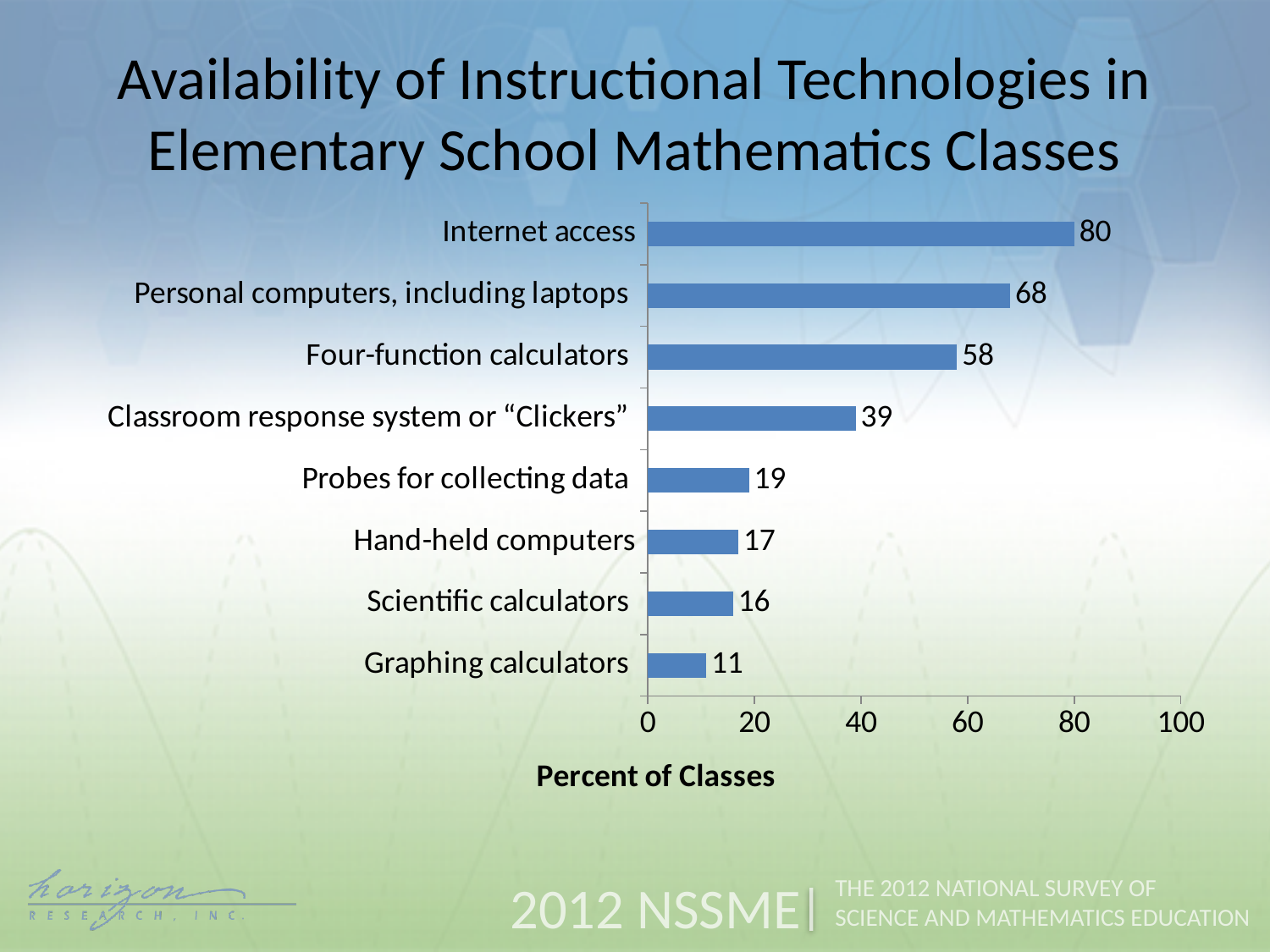
Which is larger, the value for Probes for collecting data or the value for Hand-held computers? Probes for collecting data What is the value for Classroom response system or "Clickers"? 39 How many categories are shown in the chart? 8 What is the difference between the values for Personal computers, including laptops and Four-function calculators? 10 What kind of chart is shown on the slide? bar chart Which category has the lowest value? Graphing calculators Which category has the highest value? Internet access What is the value for Internet access? 80 What is the difference between the values for Scientific calculators and Graphing calculators? 5 Is the value for Four-function calculators greater or less than 40? greater What is the label of the horizontal axis? Percent of Classes What is the value for Graphing calculators? 11